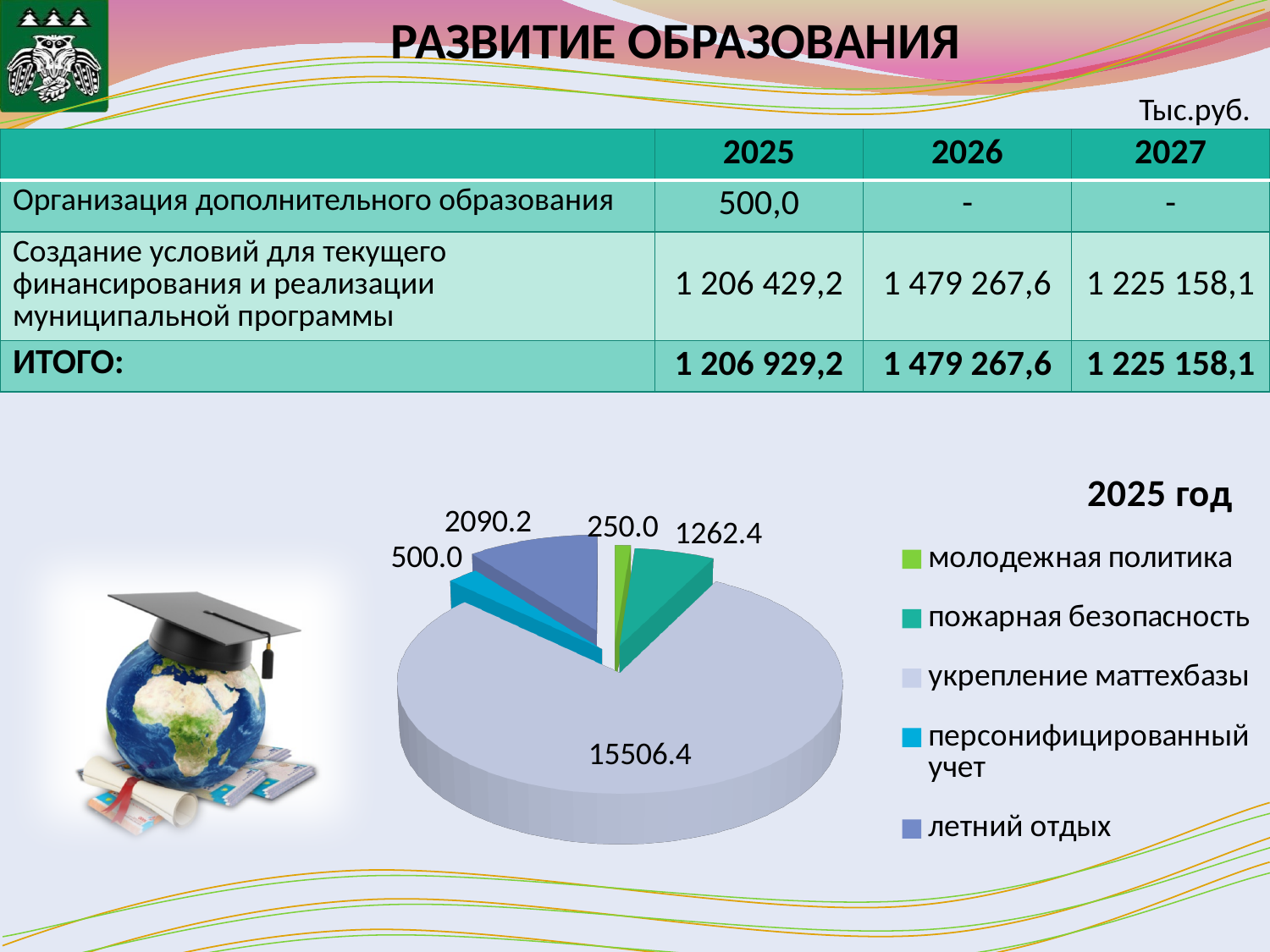
Which category has the largest slice in the pie chart? укрепление маттехбазы What is the value for летний отдых in the pie chart? 2090.2 What is the value for укрепление маттехбазы in the pie chart? 15506.4 Which category has the smallest slice in the pie chart? молодежная политика What is the value for персонифицированный учет in the pie chart? 500.0 What kind of chart is shown on the slide? pie chart What is the title of the pie chart? 2025 год What is the value for пожарная безопасность in the pie chart? 1262.4 Which is larger, the value for персонифицированный учет or the value for пожарная безопасность? пожарная безопасность What is the value for молодежная политика in the pie chart? 250.0 What is the difference between the values for летний отдых and пожарная безопасность? 827.8 How many categories does the pie chart legend list? 5